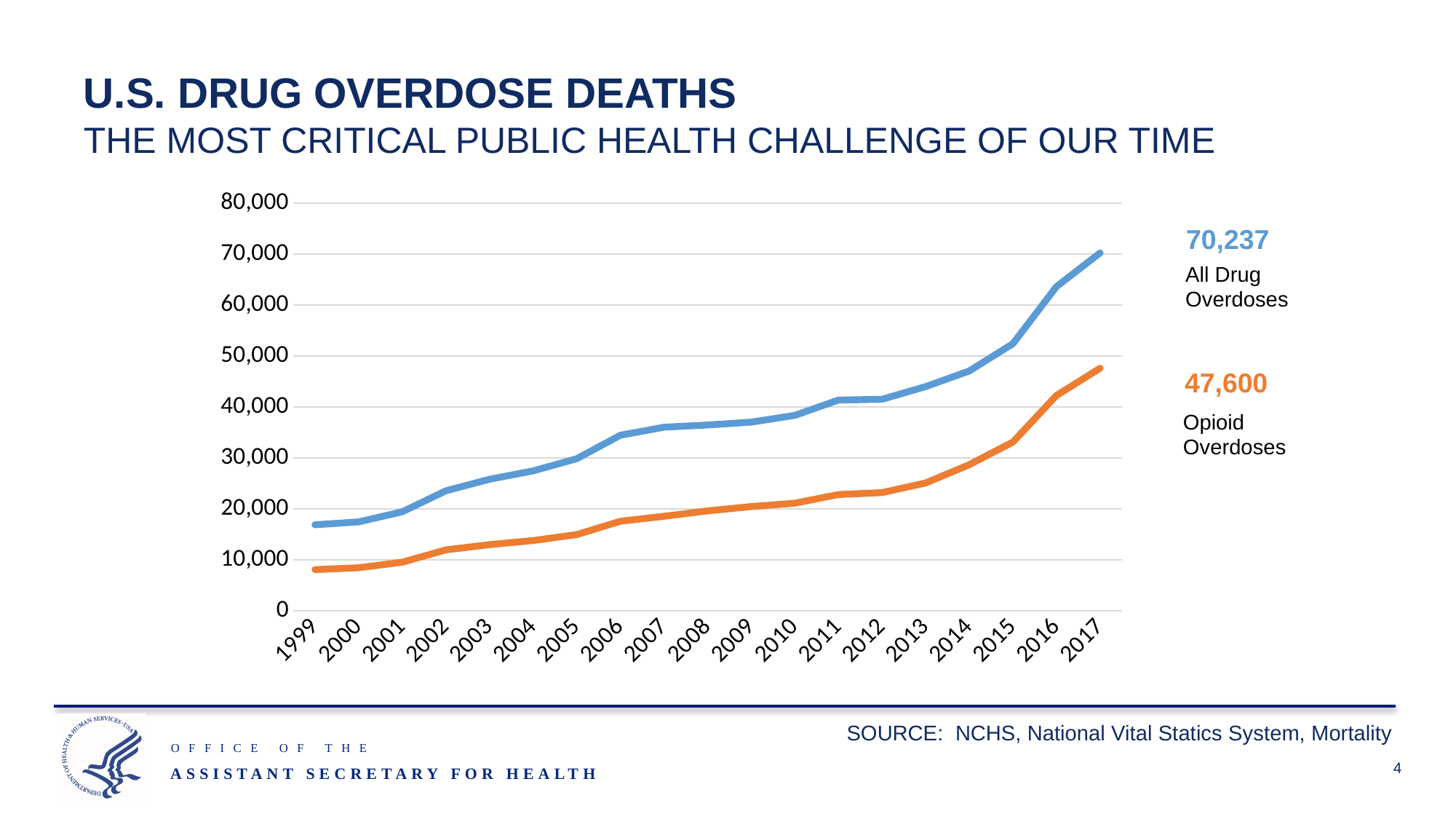
How many years are shown on the x axis? 19 Is the value for All Drug Overdoses in 1999 greater or less than 20,000? less What is the value for Opioid Overdoses in 2017? 47,600 Do the values for All Drug Overdoses rise or fall from 1999 to 2017? rise What is the difference between All Drug Overdoses and Opioid Overdoses in 2017? 22,637 How many series are plotted on the chart? 2 Is the value for Opioid Overdoses in 2015 greater or less than 30,000? greater What colour is the line for All Drug Overdoses? blue What kind of chart is shown on the slide? line chart In 2017, which is larger: All Drug Overdoses or Opioid Overdoses? All Drug Overdoses In which year is the value for Opioid Overdoses lowest? 1999 What is the value for All Drug Overdoses in 2017? 70,237